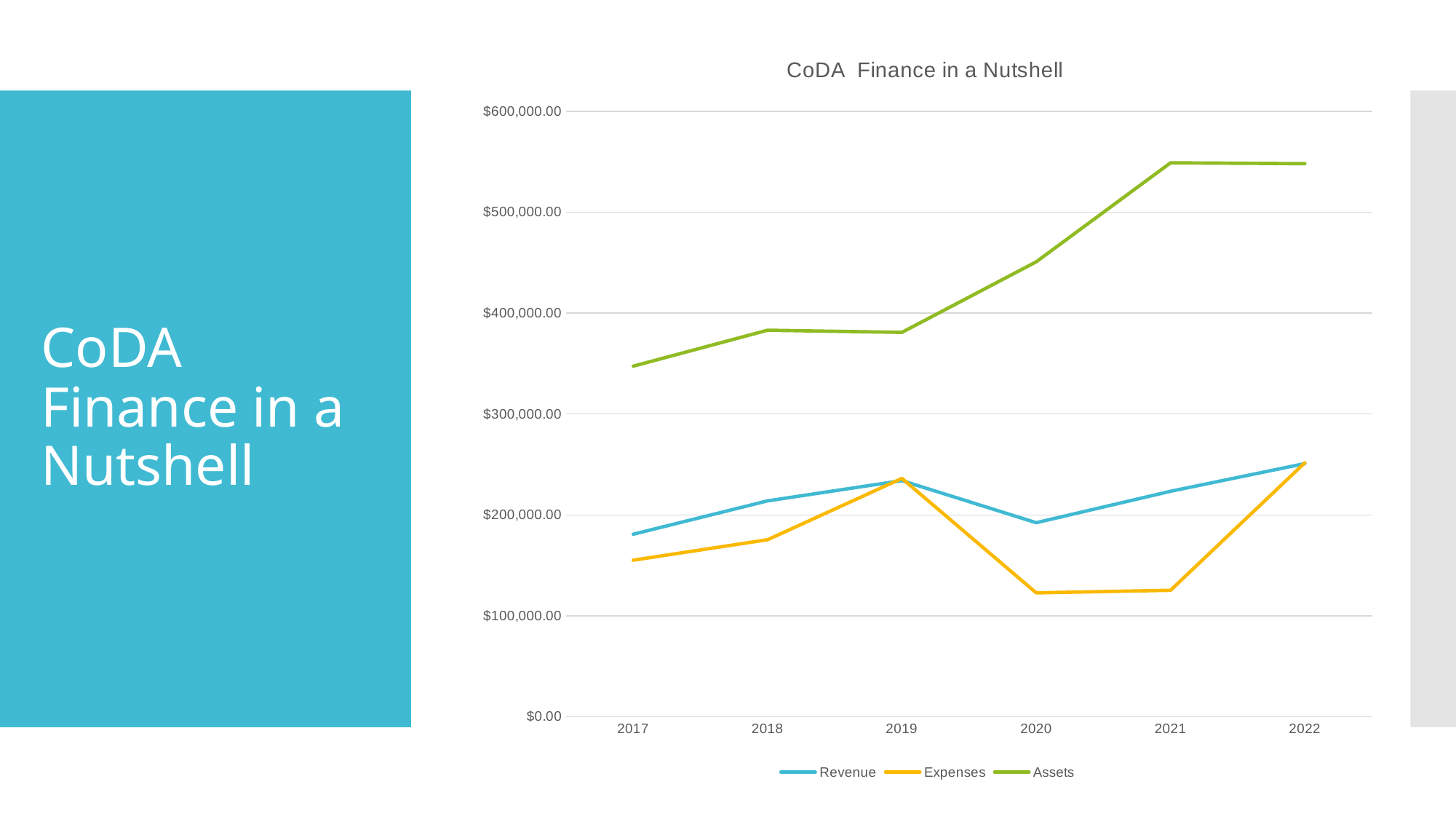
In which year are Expenses highest? 2022 In which year are Assets lowest? 2017 What is the title of the chart? CoDA Finance in a Nutshell Is the value for Assets in 2017 greater or less than $300,000.00? greater Is the value for Assets in 2021 greater or less than $500,000.00? greater What kind of chart is shown on the slide? line chart How many series does the legend list? 3 Do Assets rise or fall overall from 2017 to 2022? rise Is the value for Revenue in 2017 greater or less than $200,000.00? less How many years are plotted along the x axis? 6 In 2020, which is larger, Revenue or Expenses? Revenue